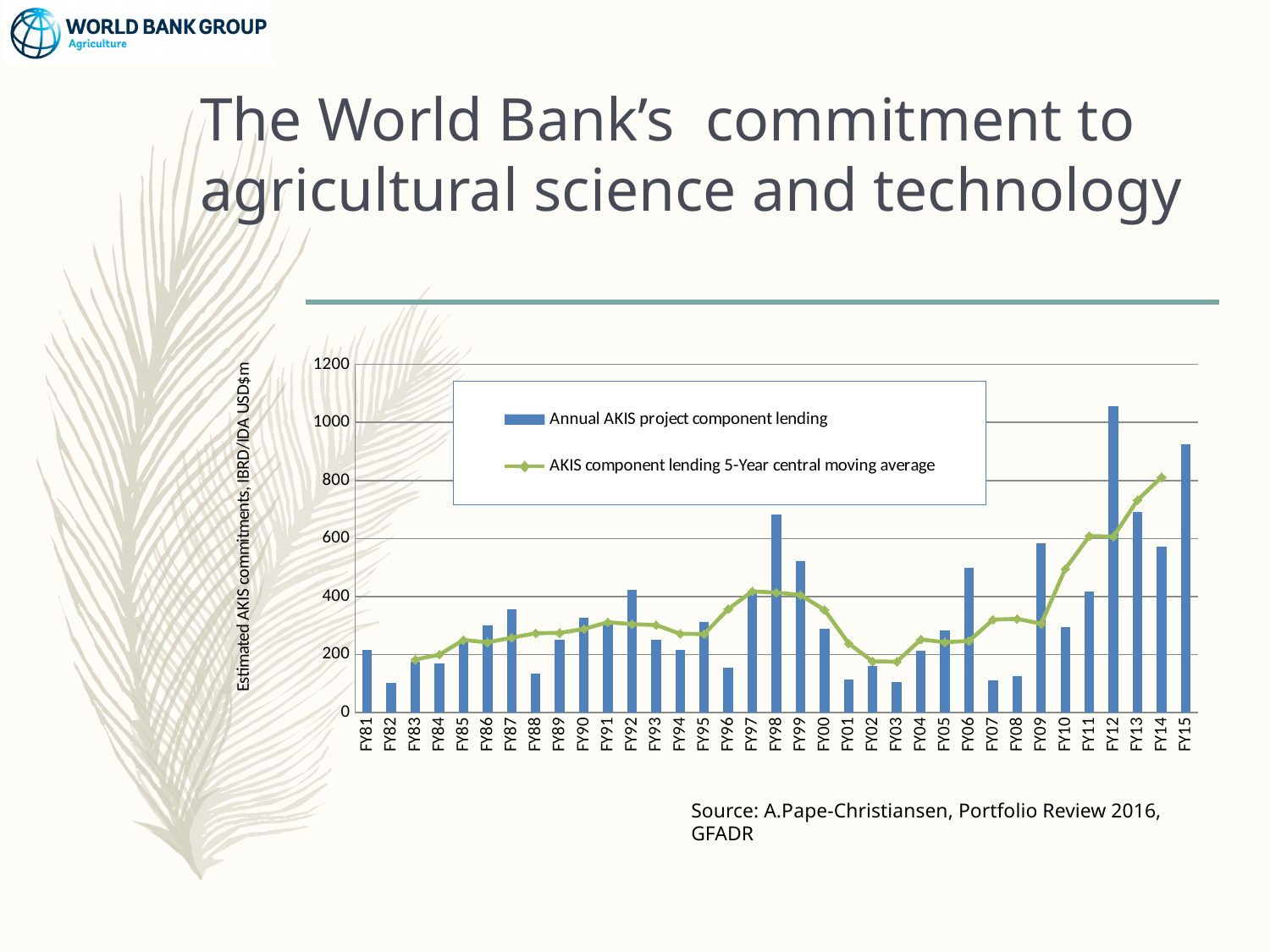
What kind of chart is used to show the annual AKIS project component lending? bar chart How many fiscal years are shown on the x axis of the chart? 35 What is the label on the vertical axis of the chart? Estimated AKIS commitments, IBRD/IDA USD$m Which has the larger annual AKIS project component lending, FY98 or FY99? FY98 Is the annual AKIS project component lending for FY12 greater or less than 1000? greater Is the annual AKIS project component lending for FY82 greater or less than 200? less How many series does the chart legend list? 2 Is the annual AKIS project component lending for FY15 greater or less than 800? greater Which has the larger annual AKIS project component lending, FY13 or FY15? FY15 Which fiscal year has the highest annual AKIS project component lending? FY12 Does the AKIS component lending 5-Year central moving average rise or fall from FY09 to FY14? rise